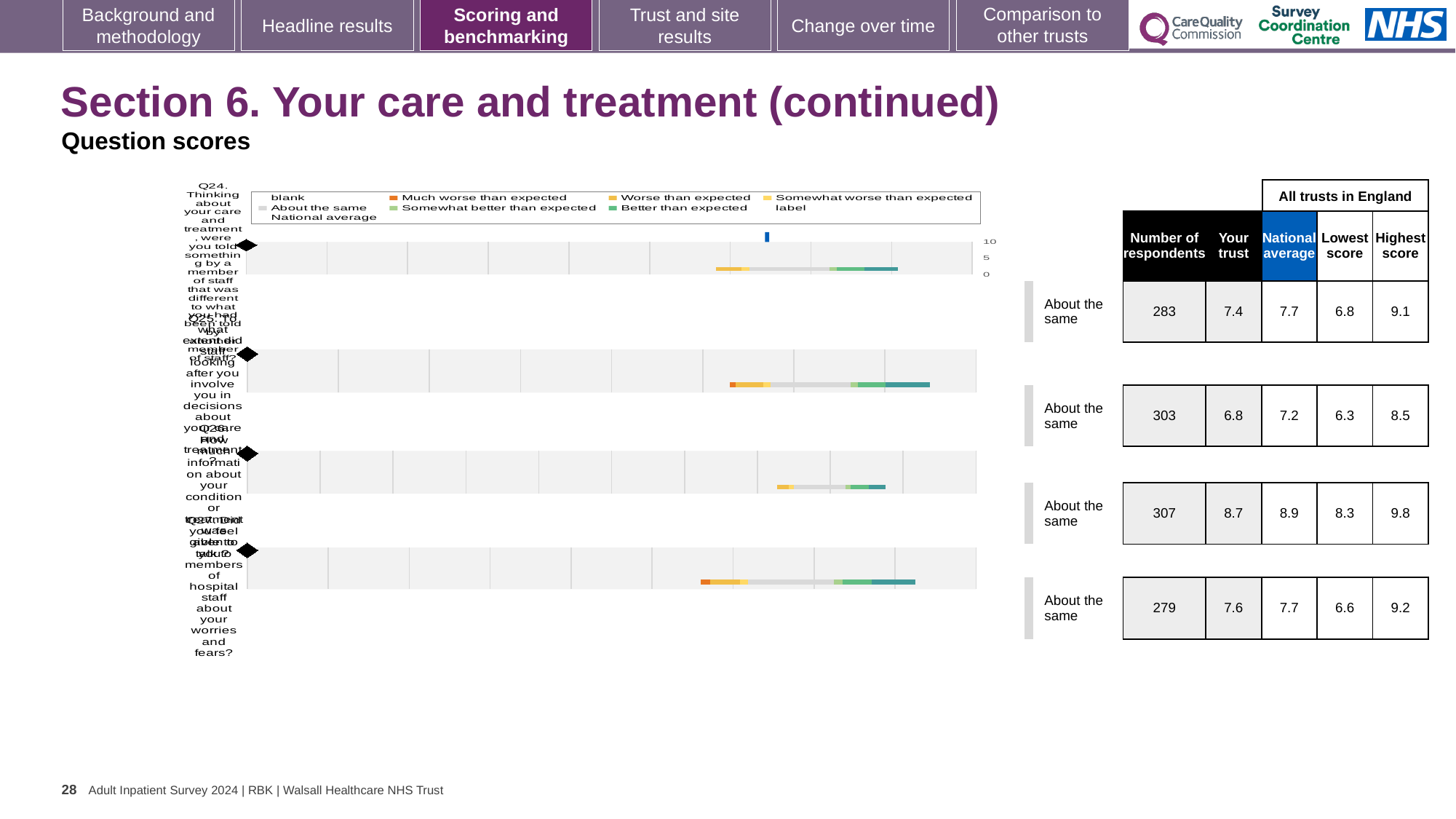
What kind of chart is used to show the benchmarking bands for each question on this slide? bar chart Which row of the table has the lowest number of respondents? Q27 (fourth row), 279 In the table, what is the highest score for the fourth row (Q27)? 9.2 In the table, what is the 'Your trust' score for the first row (Q24)? 7.4 In the table, what is the number of respondents for the third row (Q26)? 307 What is the heading above the 'National average', 'Lowest score' and 'Highest score' columns in the table? All trusts in England Is the 'Your trust' score in the first row (Q24) larger or smaller than the national average in that row? smaller What benchmark category is shown next to each of the four charts? About the same What is the difference between the national average and the 'Your trust' score in the second row (Q25)? 0.4 How many question charts are shown on the slide? 4 In the table, what is the national average for the second row (Q25)? 7.2 Which row of the table has the highest 'Your trust' score? Q26 (third row), 8.7